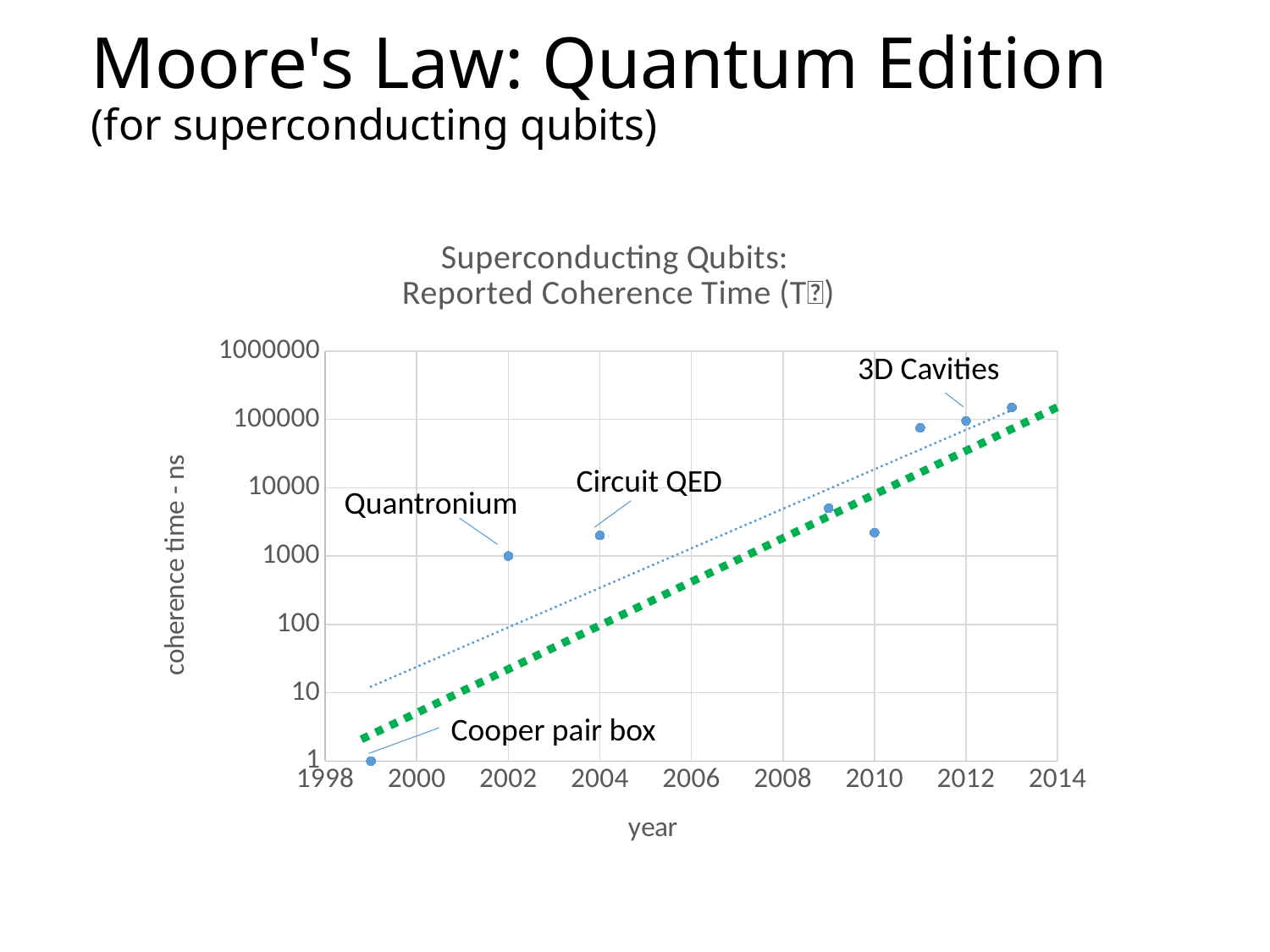
Is the coherence time for the Quantronium point (2002) greater or less than 100 ns? greater What kind of chart is shown on the slide? scatter chart What is the label of the chart's x axis? year Which year has the lowest plotted coherence time? 1999 How many data points are plotted in the chart? 8 Is the coherence time for the 3D Cavities point (2012) greater or less than 10000 ns? greater What is the label of the chart's y axis? coherence time - ns Which labelled point has the higher coherence time, Quantronium or 3D Cavities? 3D Cavities Which year has the highest plotted coherence time? 2013 Is the coherence time for the Cooper pair box point (1999) greater or less than 10 ns? less Do the reported coherence times rise or fall as the year increases? rise